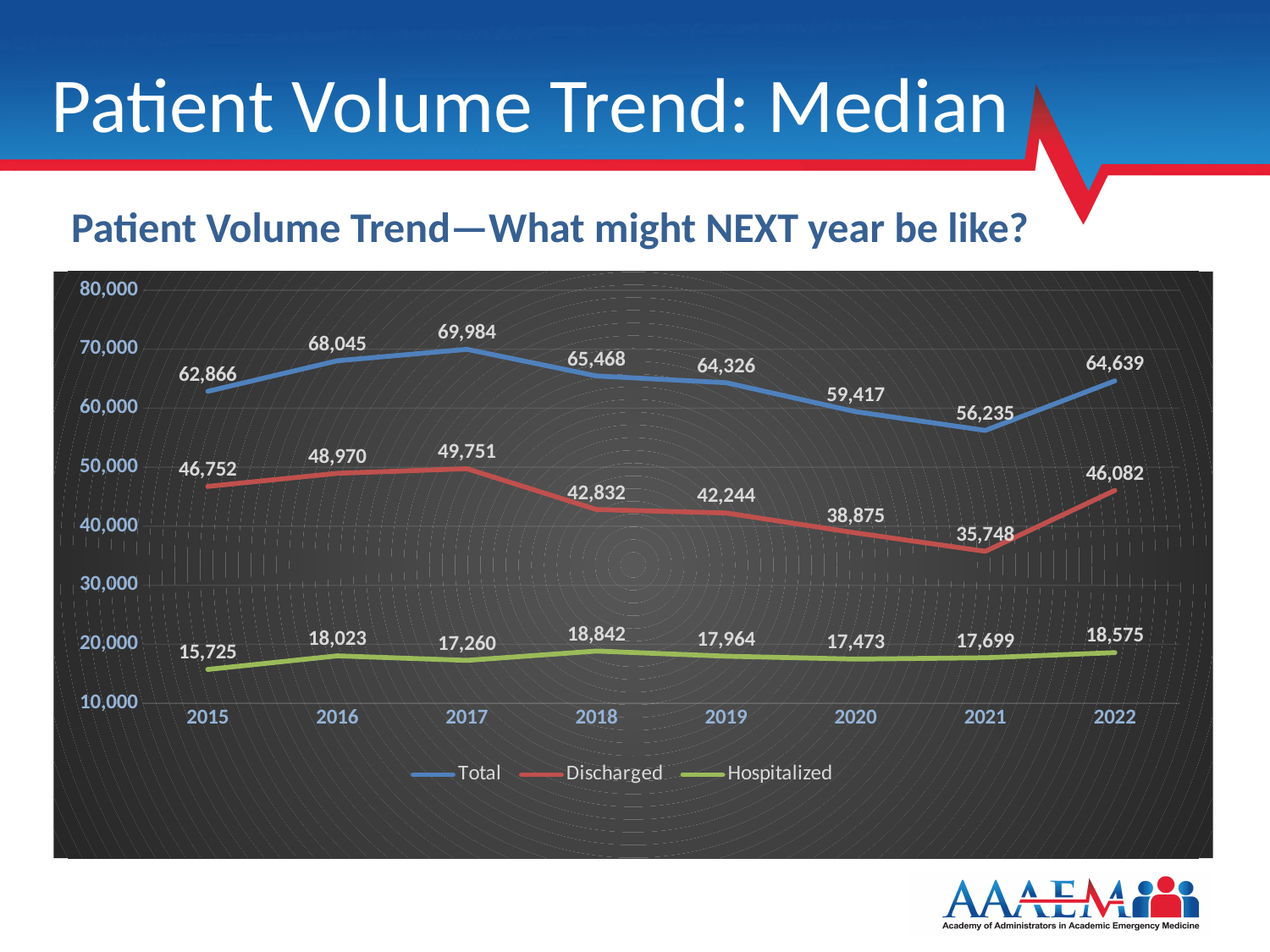
How many series does the legend list? 3 Which is larger, the Hospitalized value for 2016 or for 2017? 2016 What is the difference between the Discharged values for 2022 and 2021? 10,334 What is the Total value for 2017? 69,984 What is the difference between the Total values for 2017 and 2021? 13,749 What is the Discharged value for 2021? 35,748 In which year is the Hospitalized series lowest? 2015 Is the Total value for 2021 greater or less than 60,000? less What is the Hospitalized value for 2015? 15,725 How many years are shown on the x axis? 8 What kind of chart is shown on the slide? line chart In which year is the Total series highest? 2017